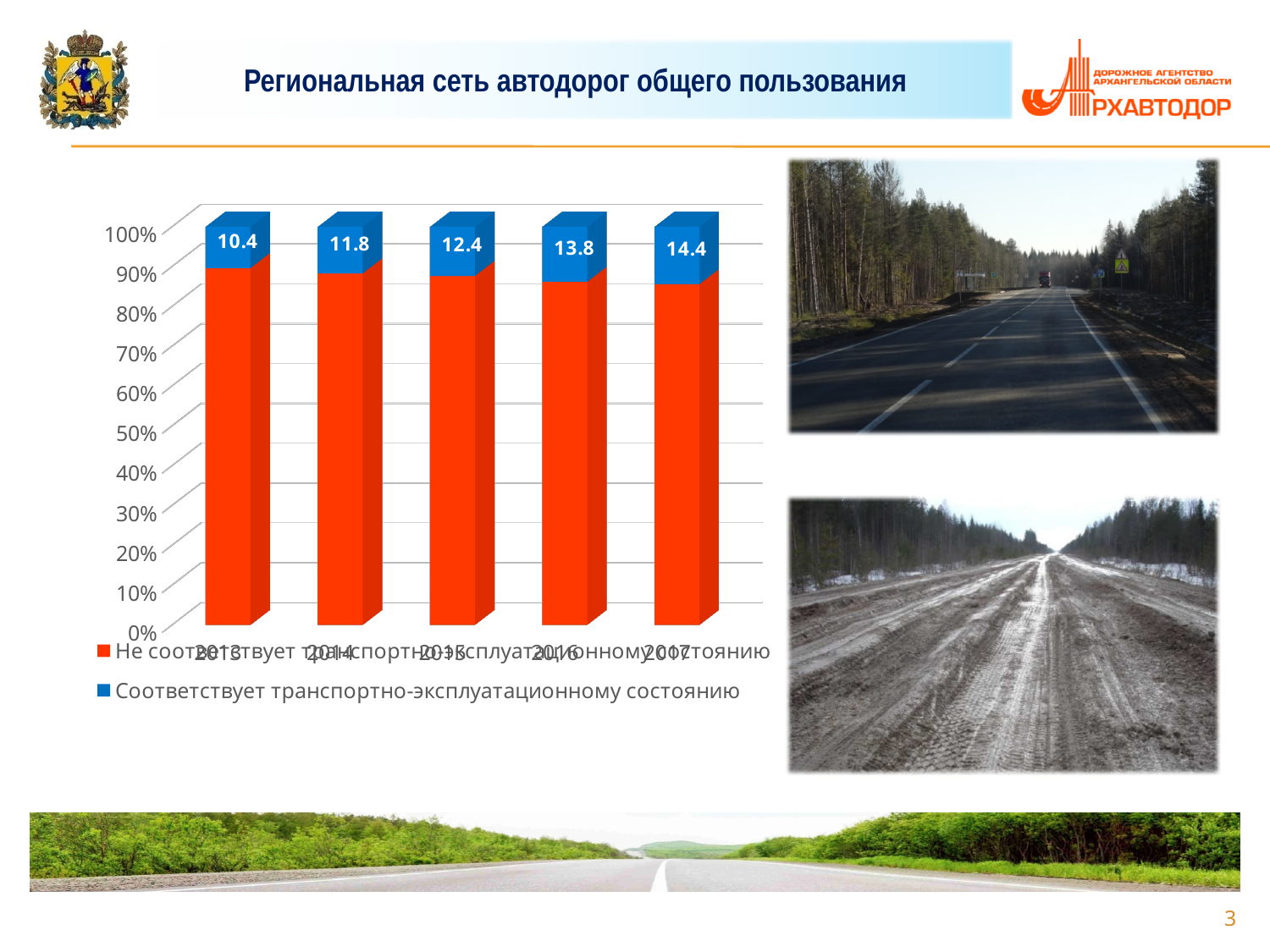
What is the value labelled on the blue segment for 2015? 12.4 What kind of chart is shown on the slide? stacked bar chart How many series does the chart legend list? 2 Which year has the lowest labelled value for the blue series? 2013 What is the value labelled on the blue segment for 2013? 10.4 What is the difference between the blue series labels for 2017 and 2013? 4.0 Which is larger, the blue series label for 2014 or for 2016? 2016 What is the value labelled on the blue segment for 2017? 14.4 How many years are shown on the x axis of the chart? 5 Which year has the highest labelled value for the blue series (Соответствует транспортно-эксплуатационному состоянию)? 2017 Do the labelled values of the blue series rise or fall from 2013 to 2017? rise Is the red segment for 2013 greater or less than 80%? greater